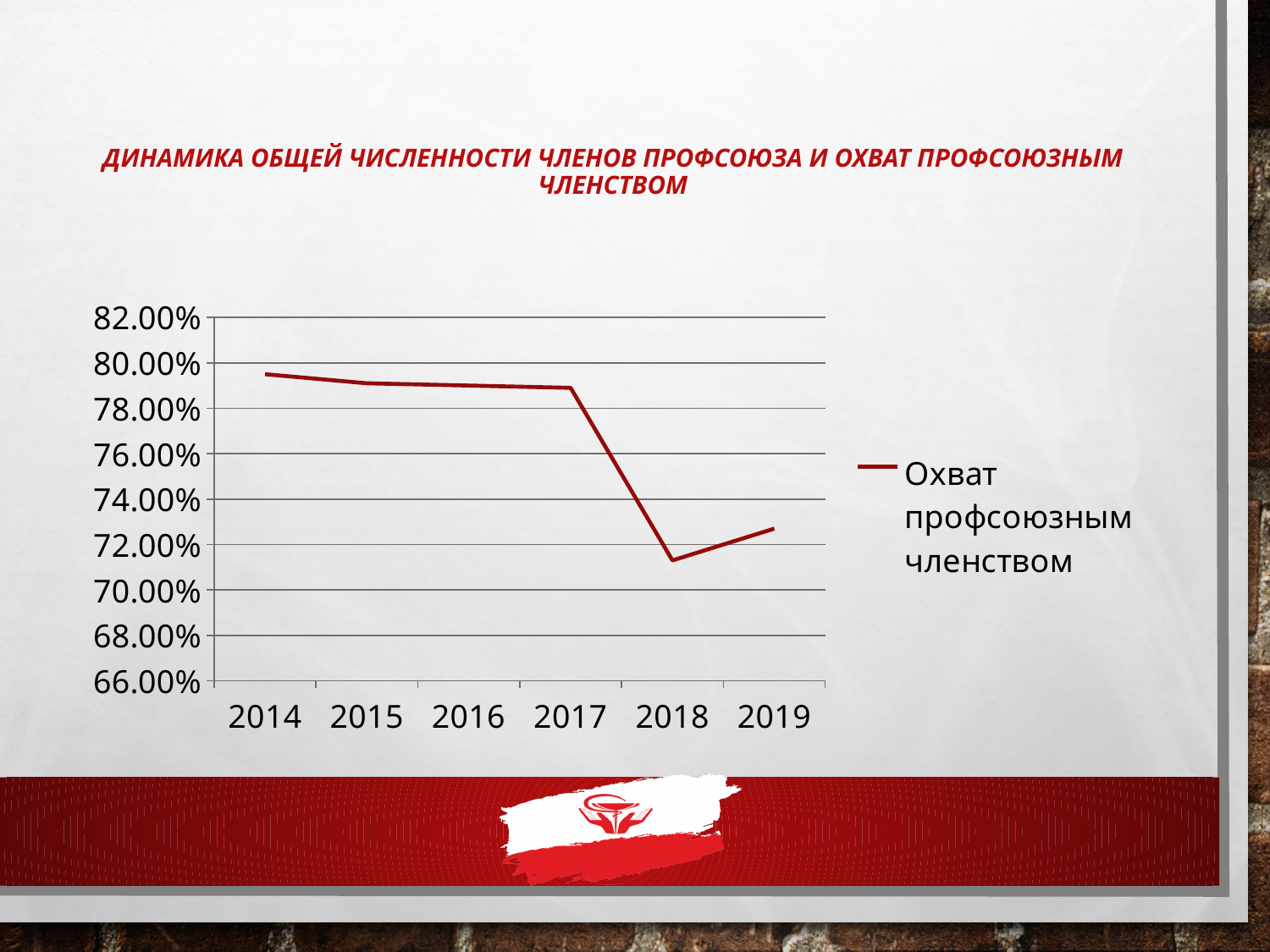
Is the value for 2017 greater or less than 78.00%? greater How many years are plotted on the x axis of the chart? 6 Which year has the highest value for Охват профсоюзным членством? 2014 Which year has the lowest value for Охват профсоюзным членством? 2018 How many series does the chart's legend list? 1 Which is larger, the value for 2017 or the value for 2018? 2017 What is the name of the series shown in the chart's legend? Охват профсоюзным членством What kind of chart is shown on the slide? line chart Is the value for 2018 greater or less than 72.00%? less Is the value for 2019 greater or less than 72.00%? greater Does the value for Охват профсоюзным членством rise or fall overall from 2014 to 2019? fall